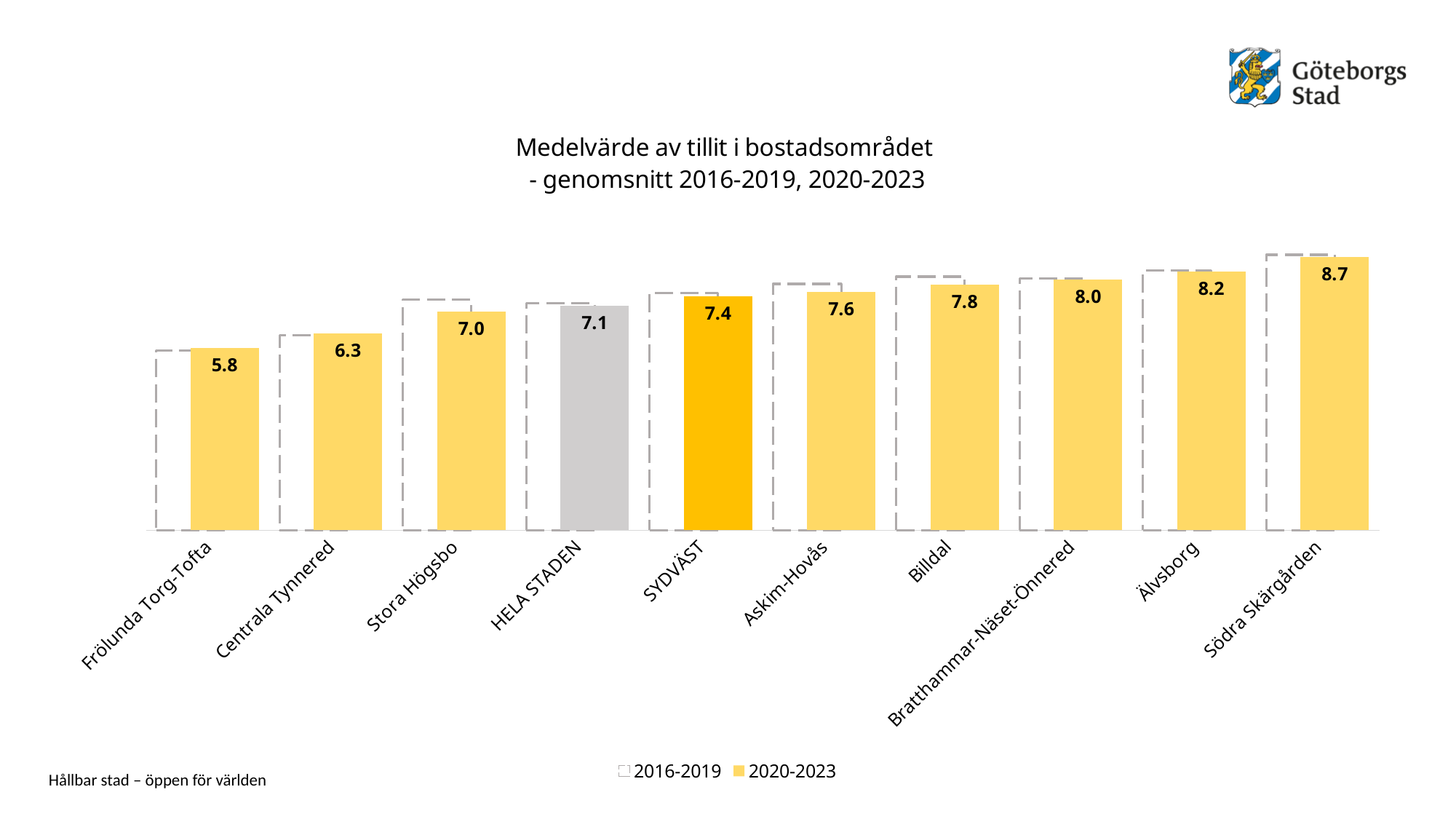
Do the 2020-2023 values rise or fall from left to right along the x axis? Rise Which category has the lowest 2020-2023 value? Frölunda Torg-Tofta What is the 2020-2023 value for Frölunda Torg-Tofta? 5.8 Which category has the highest 2020-2023 value? Södra Skärgården What kind of chart is shown on the slide? Bar chart What is the 2020-2023 value for Bratthammar-Näset-Önnered? 8.0 How many series does the legend list? 2 What is the 2020-2023 value for HELA STADEN? 7.1 What is the 2020-2023 value for SYDVÄST? 7.4 Which has the larger 2020-2023 value, Billdal or Stora Högsbo? Billdal What is the difference between the 2020-2023 values for Södra Skärgården and Frölunda Torg-Tofta? 2.9 How many categories are shown on the x axis? 10